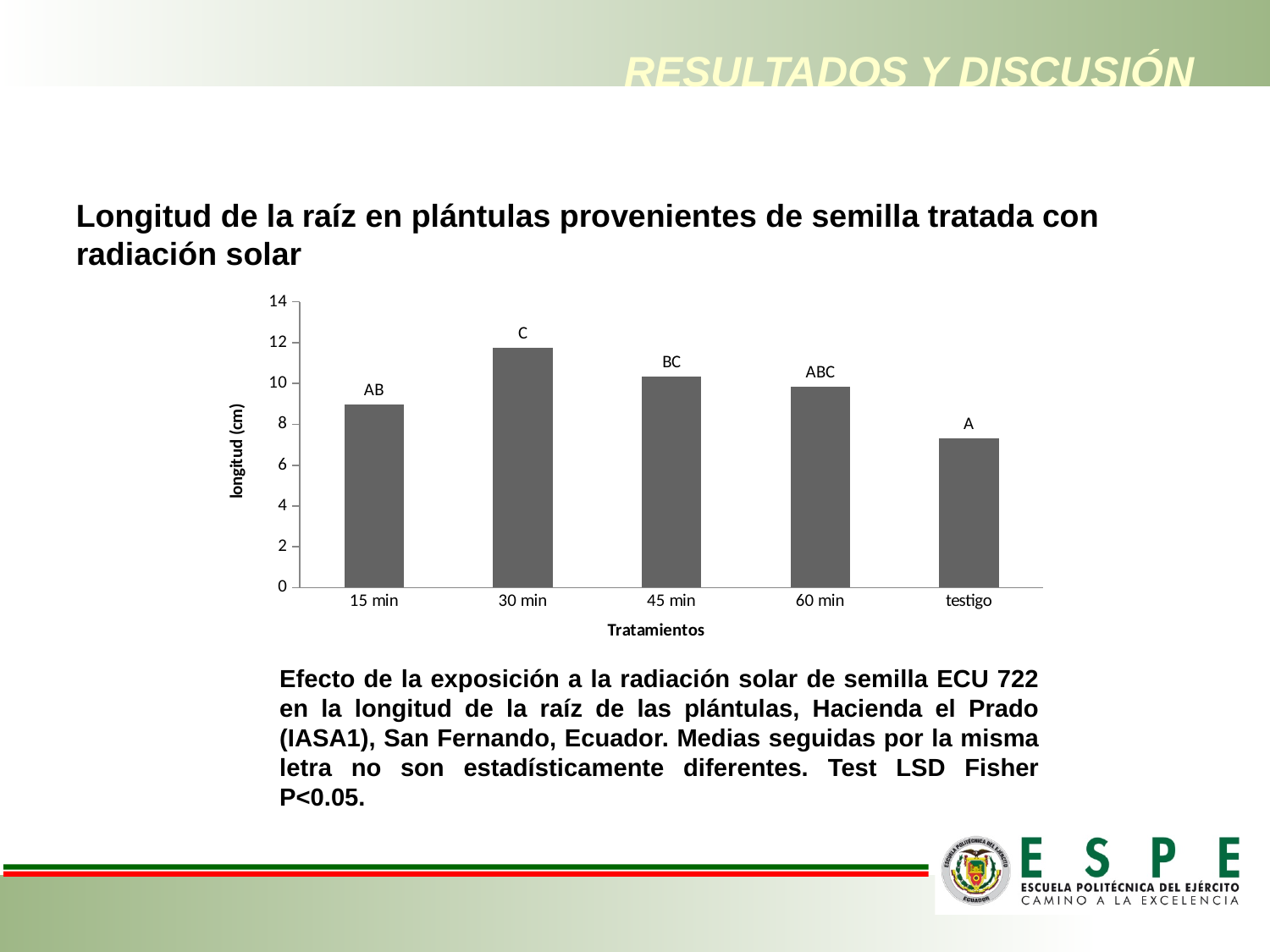
Is the value for 30 min greater or less than 10? greater Which treatment has the lowest root length? testigo What is the label on the y axis? longitud (cm) Do the values rise or fall from 30 min to testigo along the x axis? fall Which has the larger root length, 45 min or testigo? 45 min Is the value for 15 min greater or less than 10? less Is the value for testigo greater or less than 8? less How many treatment categories are plotted on the x axis? 5 Which has the larger root length, 15 min or 30 min? 30 min What kind of chart is shown on the slide? bar chart What letter label is shown above the bar for 60 min? ABC Which treatment has the highest root length? 30 min